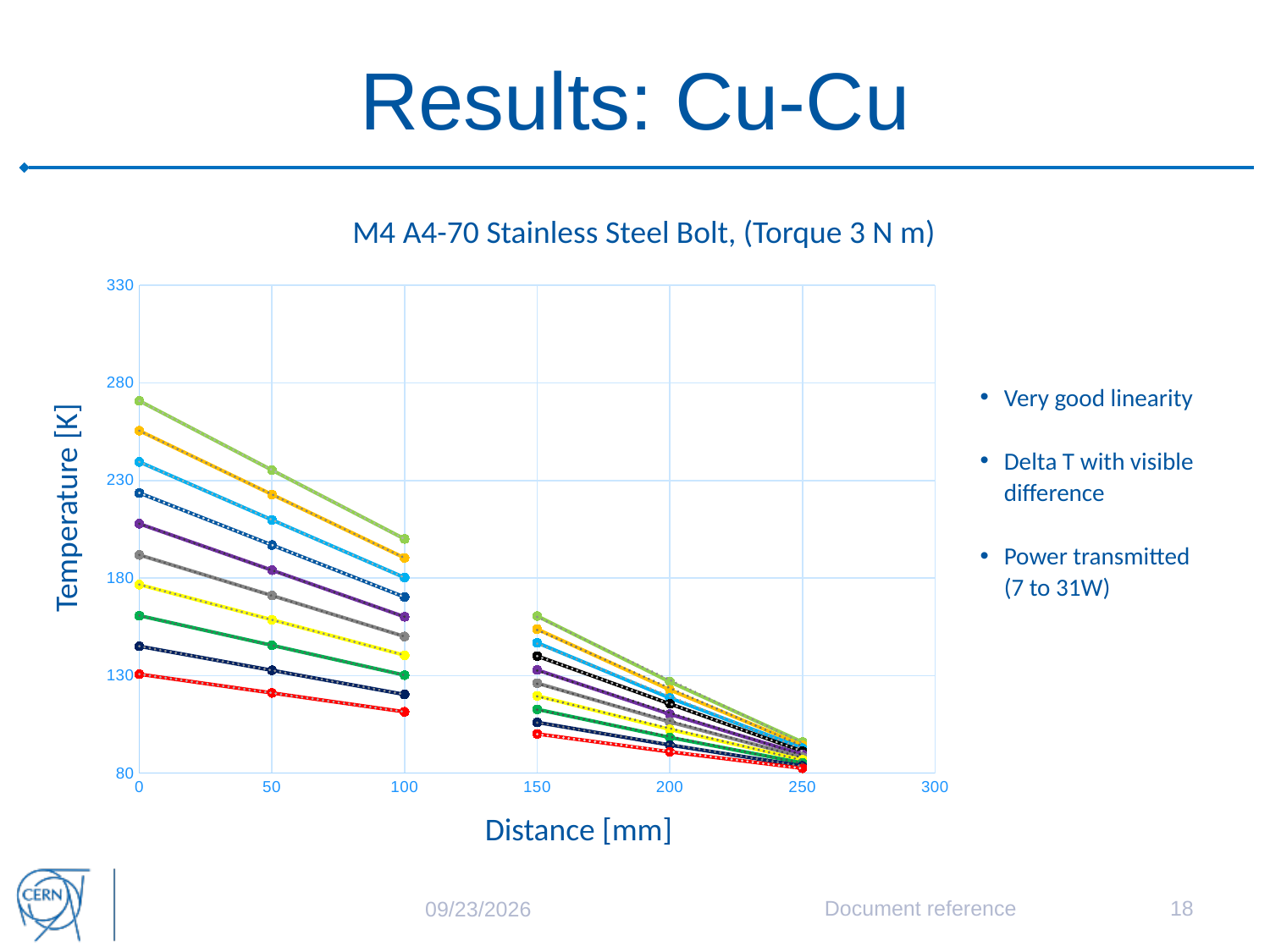
How many distance points does each line have in the left group (between 0 and 100 mm)? 3 Is the value of the red line at 250 mm greater or less than 130? less Is the value of the red line at 100 mm greater or less than 130? less Do the temperature values rise or fall as distance increases along the x axis? fall What kind of chart is shown on the slide? line chart Which coloured line has the lowest temperature at 0 mm? red Is the value of the light green line at 100 mm greater or less than 180? greater Which coloured line has the highest temperature at 0 mm? light green What is the label of the vertical axis of the chart? Temperature [K] What is the title of the chart? M4 A4-70 Stainless Steel Bolt, (Torque 3 N m) At 0 mm, is the light green line or the red line at a higher temperature? light green